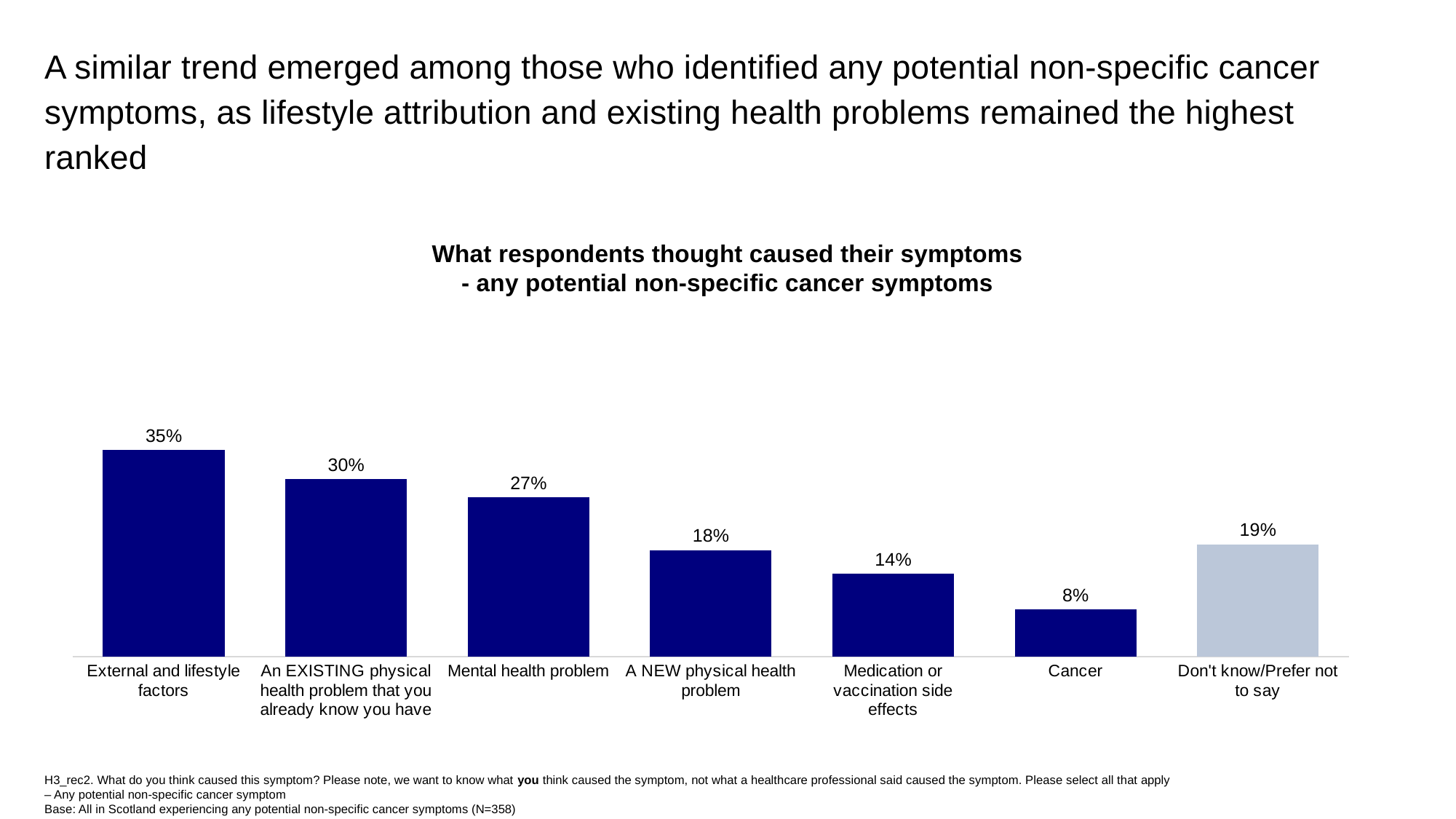
What is the value for 'Medication or vaccination side effects'? 14% Which category has the highest value? External and lifestyle factors What percentage of respondents thought cancer caused their symptoms? 8% What is the title of the chart? What respondents thought caused their symptoms - any potential non-specific cancer symptoms What percentage of respondents attributed their symptoms to external and lifestyle factors? 35% Which category has the lowest value? Cancer Which is larger: the value for 'A NEW physical health problem' or 'Don't know/Prefer not to say'? Don't know/Prefer not to say How many categories are shown in the chart? 7 Which bar is shown in a lighter colour than the others? Don't know/Prefer not to say What is the value for 'Don't know/Prefer not to say'? 19% What is the difference between the values for 'External and lifestyle factors' and 'Mental health problem'? 8 percentage points What type of chart is shown on the slide? Bar chart